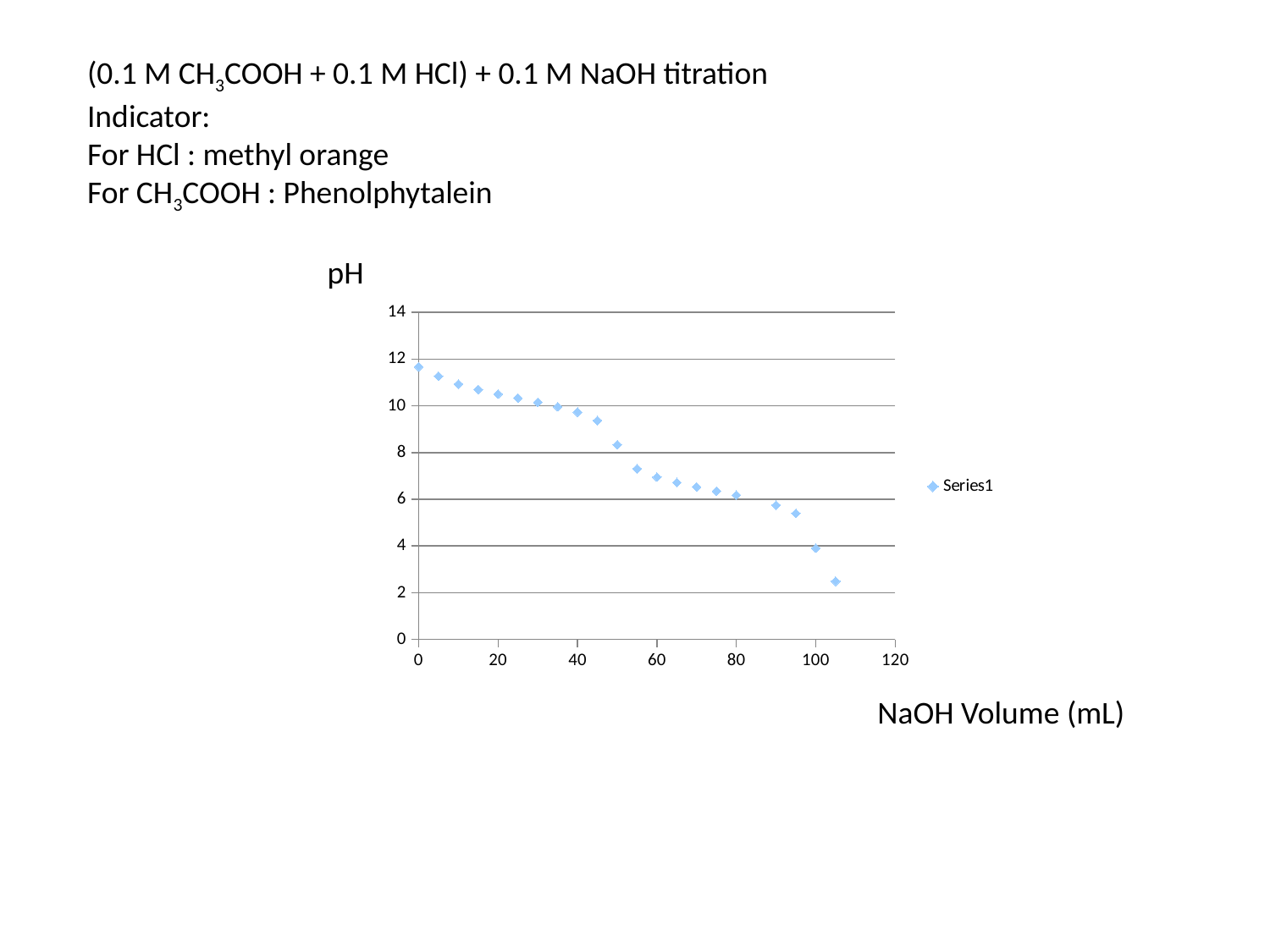
Which has the lower pH: 0 mL NaOH or 100 mL NaOH? 100 mL How many series does the legend list? 1 What is the label of the x axis? NaOH Volume (mL) Do the pH values rise or fall as the NaOH volume increases? Fall Which has the higher pH: 40 mL NaOH or 80 mL NaOH? 40 mL What is the name of the series shown in the legend? Series1 Is the pH at 100 mL NaOH greater or less than 6? less What kind of chart is shown on the slide? Scatter chart Is the pH at 0 mL NaOH greater or less than 10? greater At which NaOH volume is the pH highest? 0 Is the pH at 20 mL NaOH greater or less than 10? greater